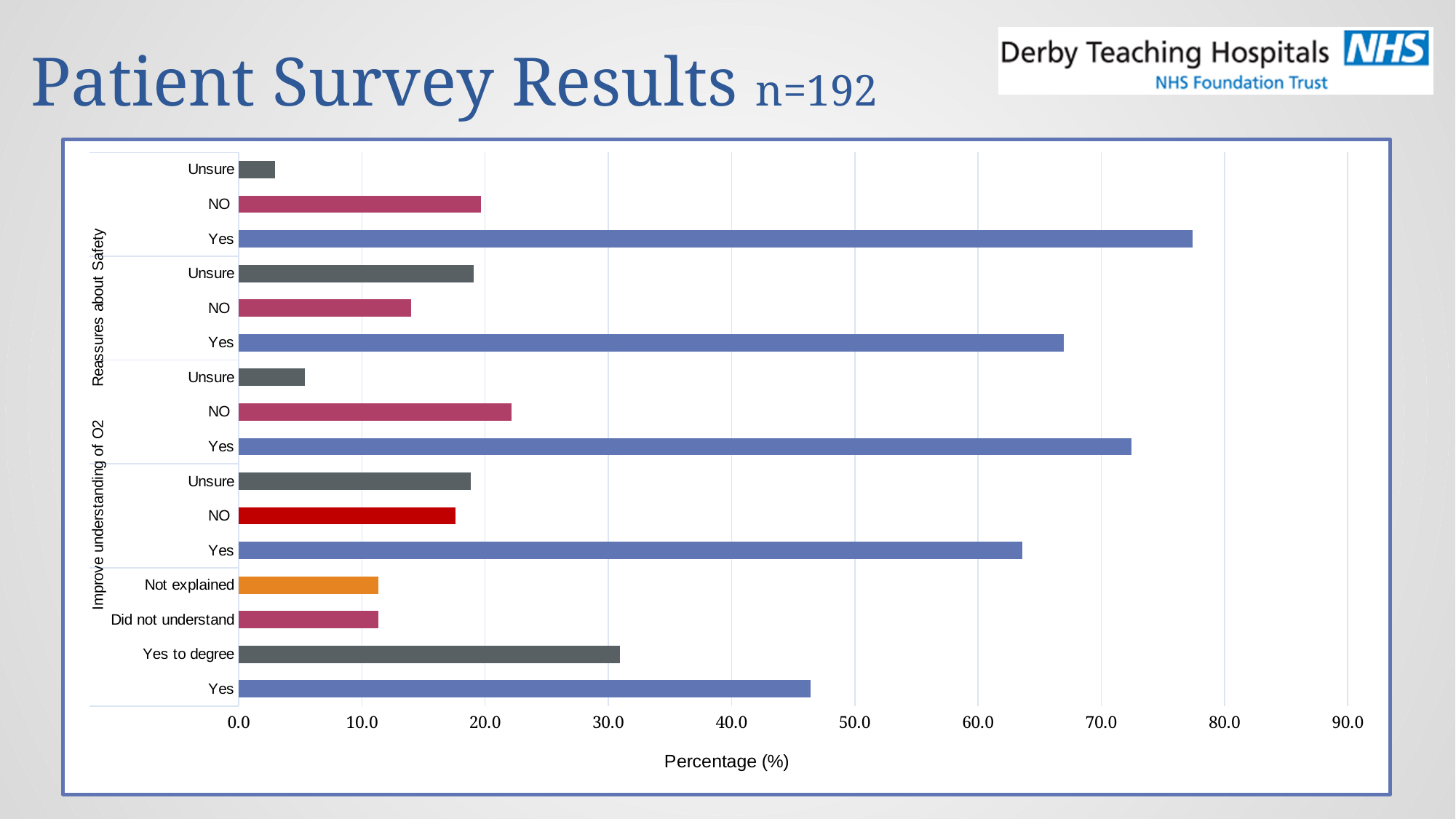
What sample size (n) is stated in the slide title? n=192 Is the value for the bottom 'Yes' bar greater or less than 50? less How many bars are plotted in the chart? 16 Which bar is the longest in the chart? the topmost Yes bar Is the value for 'Did not understand' greater or less than 20? less Is the value for the topmost 'Yes' bar greater or less than 70? greater What kind of chart is shown on the slide? bar chart Which is larger, the topmost 'Yes' bar or the bottom 'Yes' bar? the topmost Yes bar Which bar is the shortest in the chart? the topmost Unsure bar What is the title of the horizontal axis of the chart? Percentage (%)